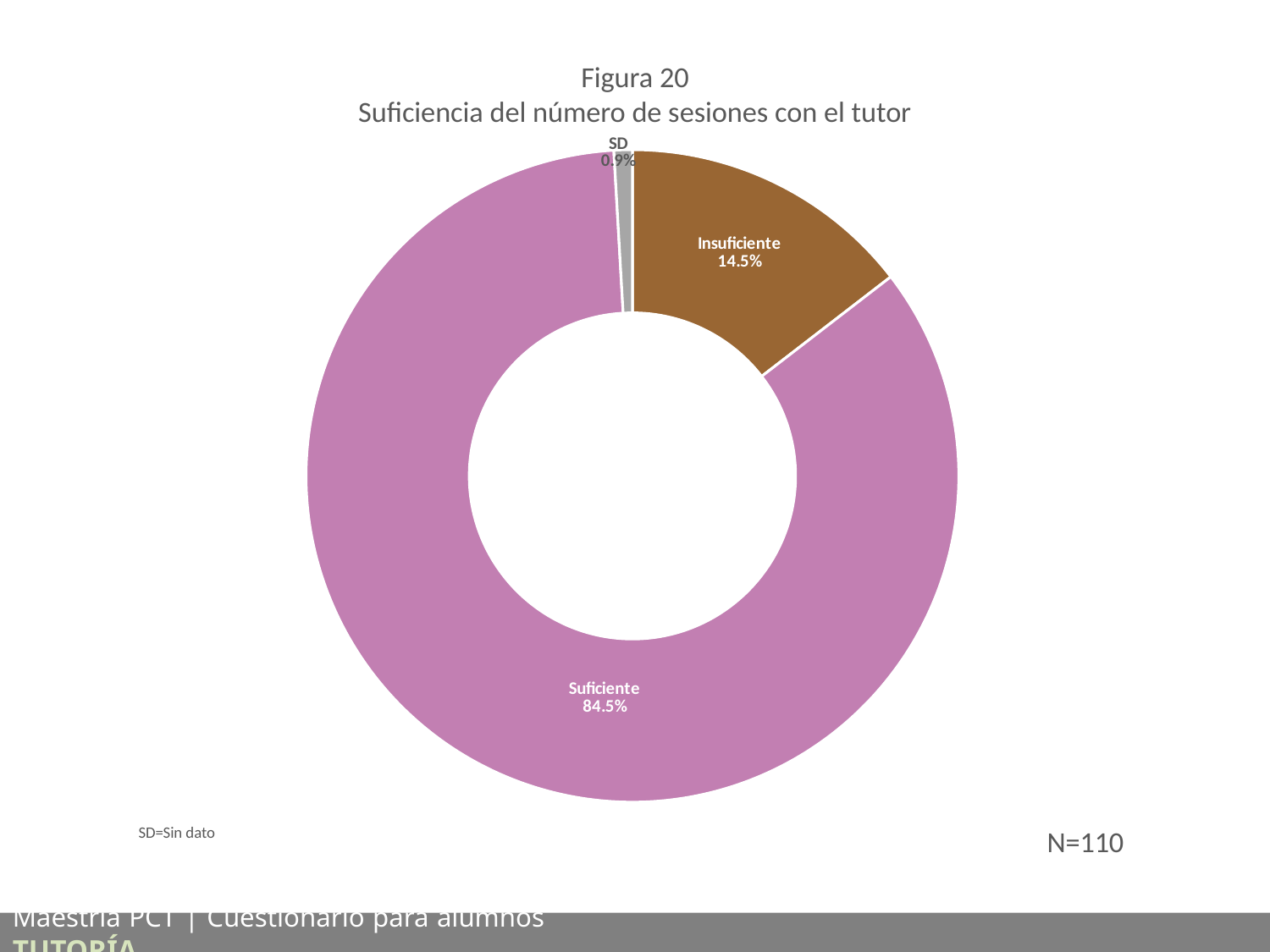
What is the sample size (N) indicated on the slide? N=110 What is the difference in percentage points between "Suficiente" and "Insuficiente"? 70 percentage points Which category has the smallest share of the chart? SD Which category has the largest share of the chart? Suficiente What percentage of respondents answered "Suficiente"? 84.5% What percentage is shown for the "SD" slice? 0.9% What kind of chart is shown on the slide? Doughnut (pie) chart How many categories are shown in the chart? 3 What does the abbreviation "SD" stand for according to the slide? Sin dato What percentage of respondents answered "Insuficiente"? 14.5% What is the title of the chart? Figura 20 Suficiencia del número de sesiones con el tutor Which is larger, the share for "Insuficiente" or the share for "SD"? Insuficiente